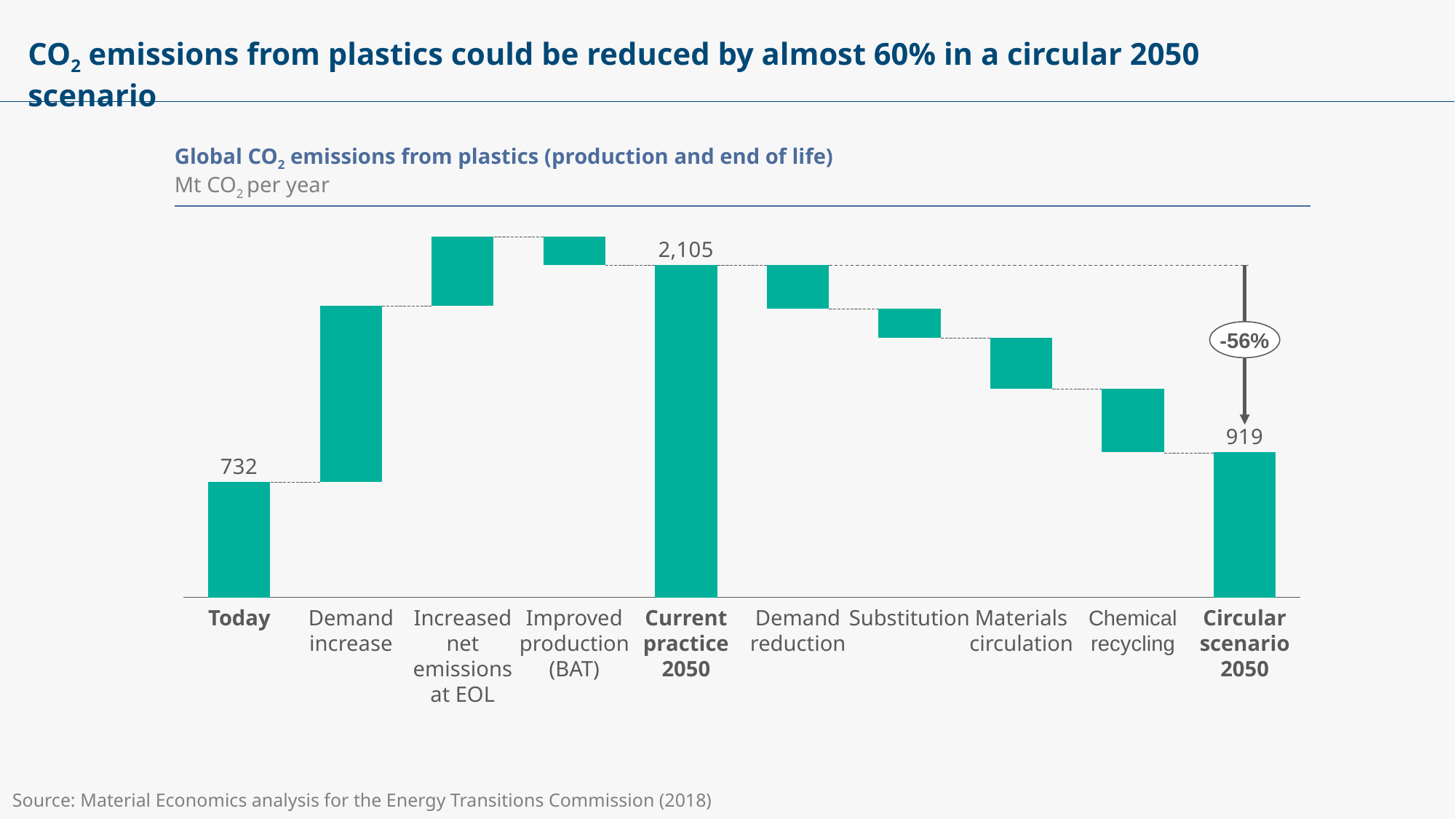
What is the value for Today? 732 How many categories are shown on the x axis? 10 Which of the three labelled totals (Today, Current practice 2050, Circular scenario 2050) is the lowest? Today What is the value for Current practice 2050? 2,105 What is the value for Circular scenario 2050? 919 What unit is the chart measured in? Mt CO2 per year What is the difference between Current practice 2050 and Today? 1,373 Which category has the highest value? Current practice 2050 What percentage change is shown by the arrow between Current practice 2050 and Circular scenario 2050? -56% What kind of chart is shown on the slide? Bar chart (waterfall) Which is larger, the value for Today or the value for Circular scenario 2050? Circular scenario 2050 What is the difference between Current practice 2050 and Circular scenario 2050? 1,186